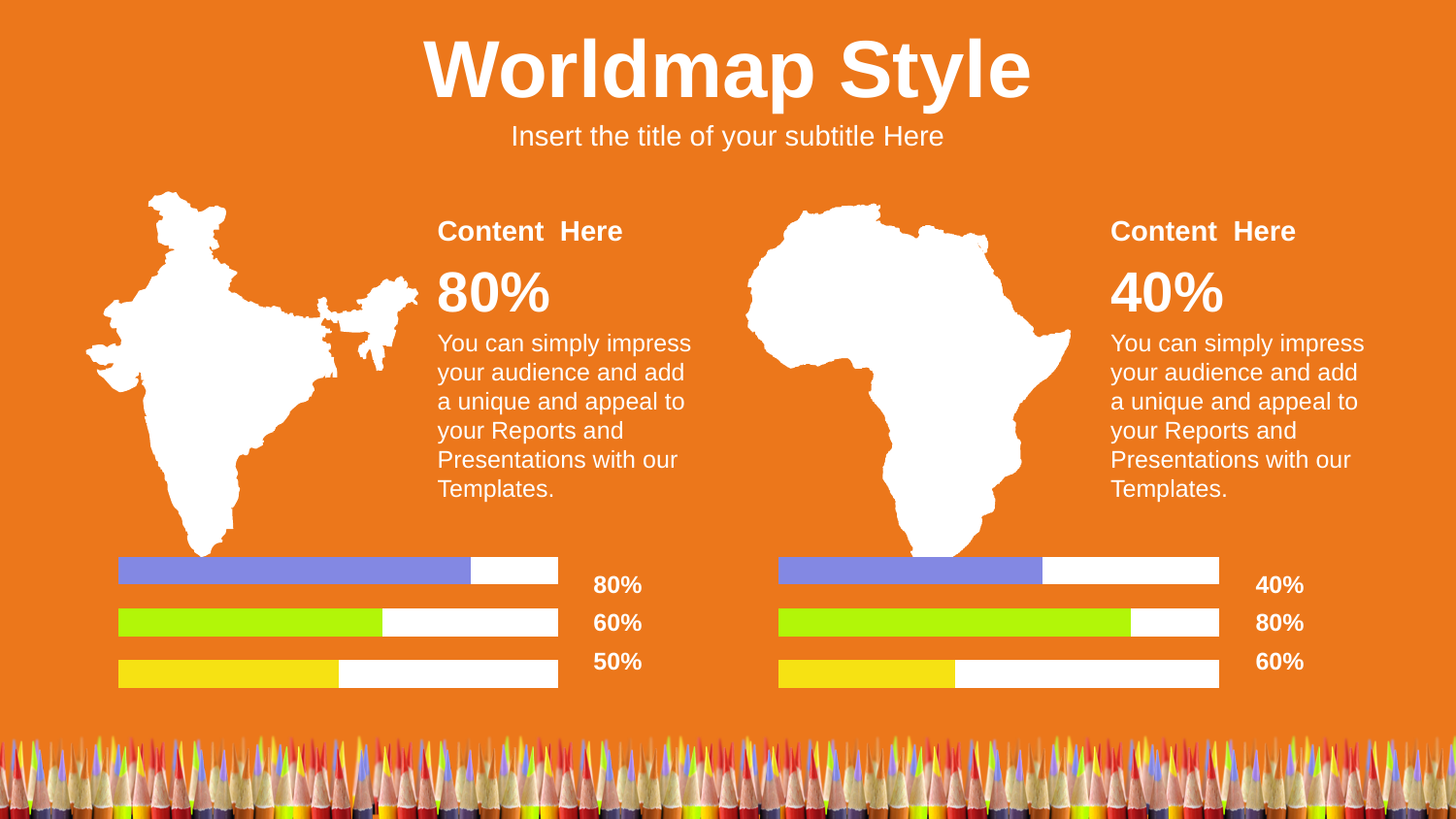
What colour is the middle bar in each chart? Green In the right bar chart under the Africa map, what value is shown for the middle (green) bar? 80% In the left bar chart under the India map, what value is shown for the top (blue) bar? 80% What type of chart is shown under each map? Bar chart In the left bar chart under the India map, which bar has the highest value? The top (blue) bar, 80% How many bars are in the left bar chart under the India map? 3 In the left bar chart under the India map, what is the difference between the top bar and the bottom bar? 30% In the left bar chart under the India map, what value is shown for the bottom (yellow) bar? 50% In the right bar chart under the Africa map, what value is shown for the top (blue) bar? 40% Is the blue bar larger in the left chart under the India map or in the right chart under the Africa map? The left chart (80% vs 40%)